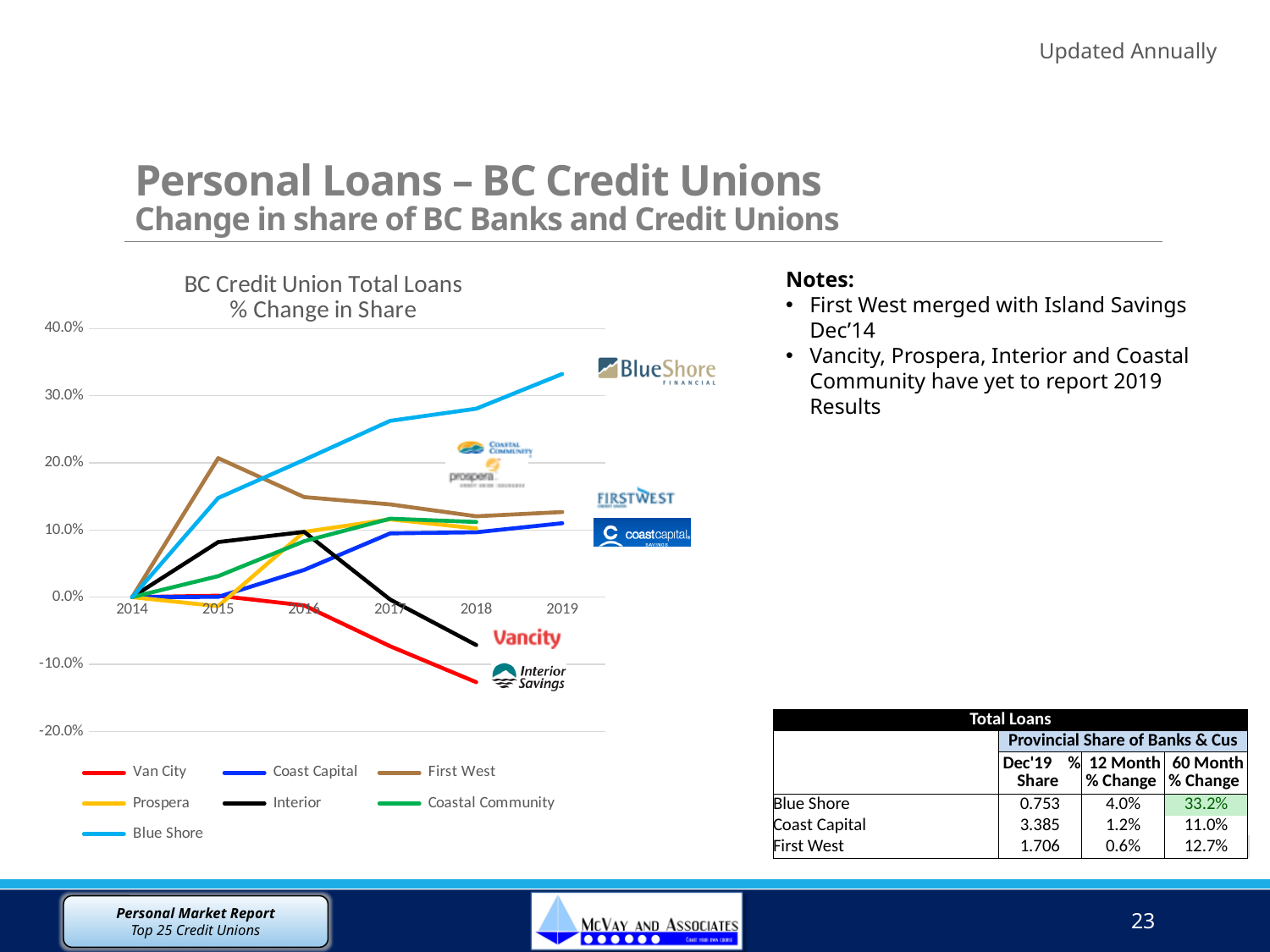
Is the value for Blue Shore in 2017 greater or less than 20.0%? greater What kind of chart is shown on the slide? line chart How many years are shown along the x axis of the chart? 6 Is the value for Blue Shore in 2019 greater or less than 30.0%? greater Which series has the highest value in 2015? First West Is the value for Interior in 2018 greater or less than 0.0%? less How many series does the chart legend list? 7 Does the Blue Shore line rise or fall from 2014 to 2019? rise Which series has the lowest value in 2018? Van City What is the title of the chart? BC Credit Union Total Loans % Change in Share Which series has the highest value in 2019? Blue Shore